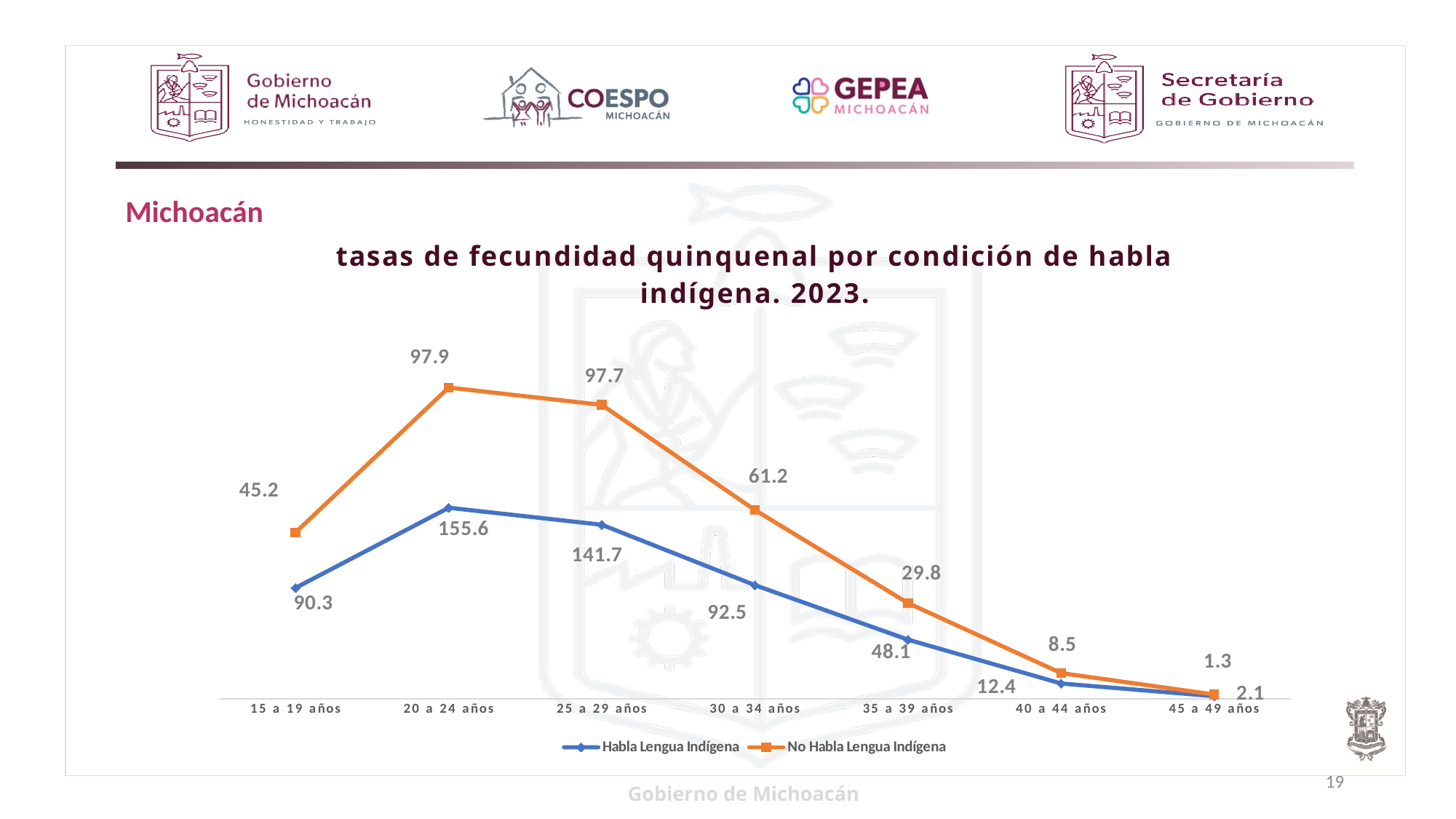
What is the data label for Habla Lengua Indígena at 20 a 24 años? 155.6 How many age groups are shown on the x axis? 7 What is the data label for Habla Lengua Indígena at 35 a 39 años? 48.1 What is the difference between the Habla Lengua Indígena labels at 20 a 24 años and 25 a 29 años? 13.9 What colour is the line for No Habla Lengua Indígena? Orange How many series does the legend list? 2 What is the data label for No Habla Lengua Indígena at 30 a 34 años? 61.2 In which age group does the No Habla Lengua Indígena series have its lowest value? 45 a 49 años What type of chart is shown on the slide? Line chart What is the data label for No Habla Lengua Indígena at 45 a 49 años? 1.3 From 25 a 29 años to 45 a 49 años, do the values of the No Habla Lengua Indígena series rise or fall? Fall In which age group does the Habla Lengua Indígena series reach its highest value? 20 a 24 años